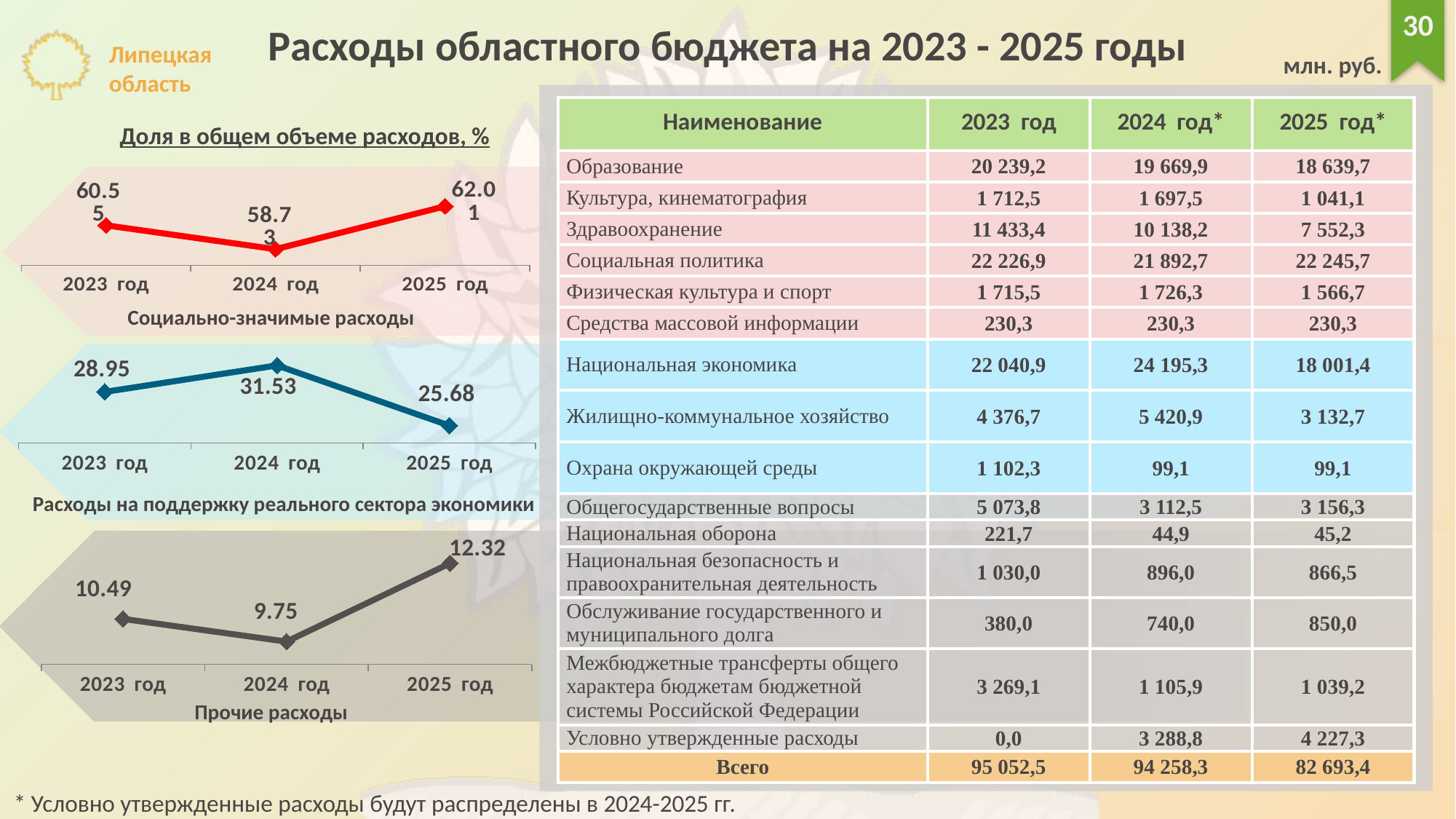
How many data points are plotted on the chart 'Прочие расходы'? 3 On the chart 'Социально-значимые расходы', which year has the lowest value? 2024 год On the chart 'Прочие расходы', what is the value for 2023 год? 10.49 On the chart 'Расходы на поддержку реального сектора экономики', does the value rise or fall from 2024 год to 2025 год? fall On the chart 'Расходы на поддержку реального сектора экономики', what is the difference between the values for 2024 год and 2023 год? 2.58 On the chart 'Прочие расходы', what is the value for 2025 год? 12.32 On the chart 'Прочие расходы', which year has the highest value? 2025 год What kind of chart is 'Расходы на поддержку реального сектора экономики'? line chart On the chart 'Прочие расходы', what is the difference between the values for 2025 год and 2024 год? 2.57 On the chart 'Социально-значимые расходы', which is larger: the value for 2025 год or the value for 2024 год? 2025 год On the chart 'Расходы на поддержку реального сектора экономики', which year has the lowest value? 2025 год On the chart 'Расходы на поддержку реального сектора экономики', what is the value for 2024 год? 31.53